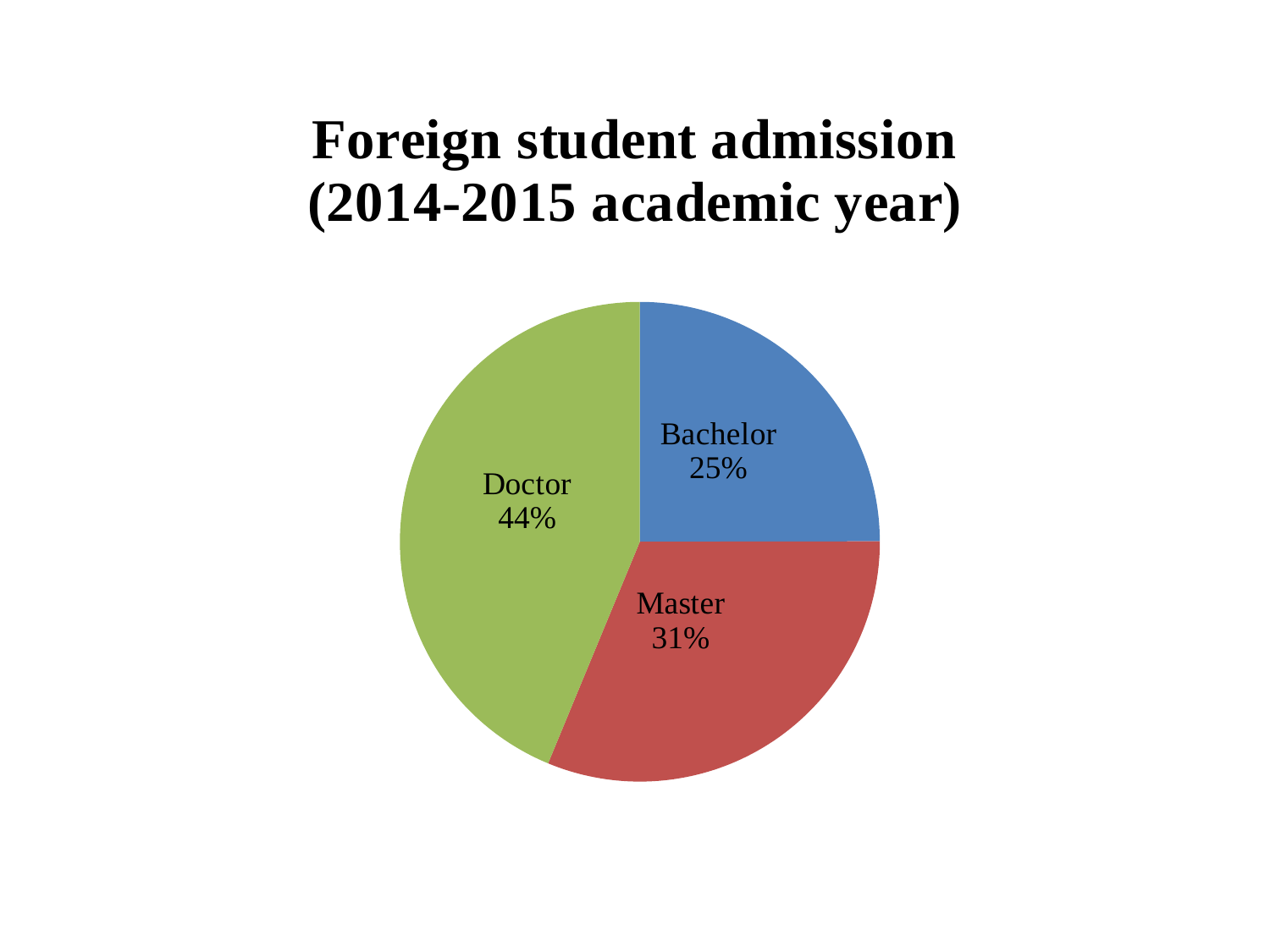
What share of foreign student admissions is Doctor? 44% What is the difference in percentage points between the Doctor and Bachelor shares? 19 What kind of chart is shown on the slide? Pie chart Which is larger, the Master share or the Bachelor share? Master What colour is the Doctor slice? Green What share of foreign student admissions is Master? 31% Which category has the smallest share of the pie? Bachelor What share of foreign student admissions is Bachelor? 25% What is the difference in percentage points between the Master and Bachelor shares? 6 How many categories does the pie chart show? 3 Which category has the largest share of the pie? Doctor What is the title of the chart? Foreign student admission (2014-2015 academic year)